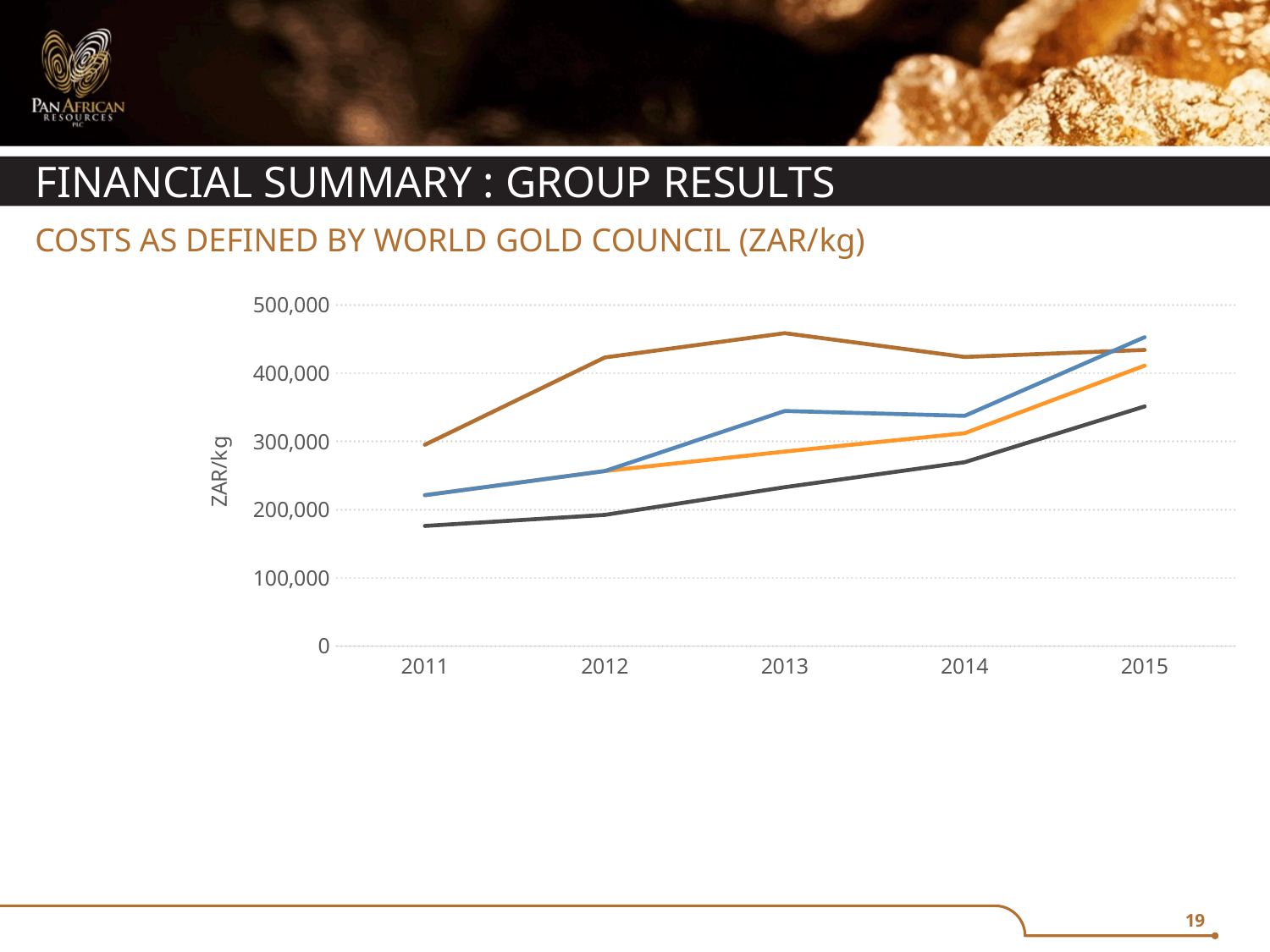
What kind of chart is shown on the slide? line chart Is the value of the brown line in 2013 greater or less than 400,000? greater In 2011, is the brown line higher or lower than the blue line? higher In which year does the dark grey line reach its highest value? 2015 How many years are shown on the x axis of the chart? 5 What is the label on the y axis of the chart? ZAR/kg Is the value of the blue line in 2015 greater or less than 400,000? greater Is the value of the orange line in 2013 greater or less than 300,000? less What is the title of the chart? COSTS AS DEFINED BY WORLD GOLD COUNCIL (ZAR/kg) How many lines are plotted on the chart? 4 Do the plotted values generally rise or fall from 2011 to 2015? rise